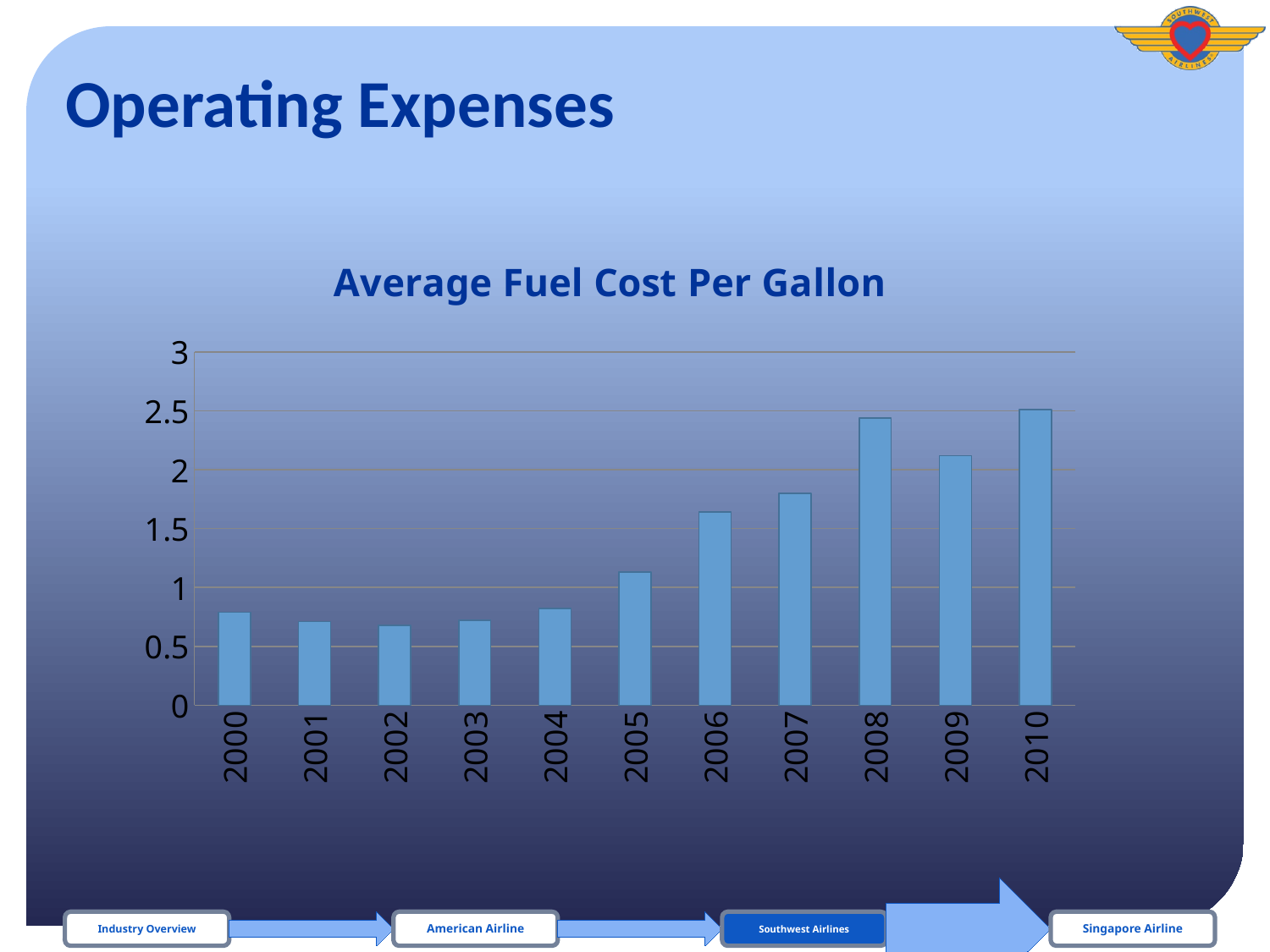
How many years are shown on the x axis of the chart? 11 Which year has the larger value, 2006 or 2007? 2007 Is the value for 2005 greater or less than 1? greater Which year has the larger value, 2008 or 2009? 2008 What kind of chart is shown on the slide? bar chart Is the value for 2002 greater or less than 1? less What is the title of the chart? Average Fuel Cost Per Gallon Is the value for 2007 greater or less than 2? less Which year has the larger value, 2004 or 2005? 2005 Overall, do the values rise or fall from 2000 to 2010? rise